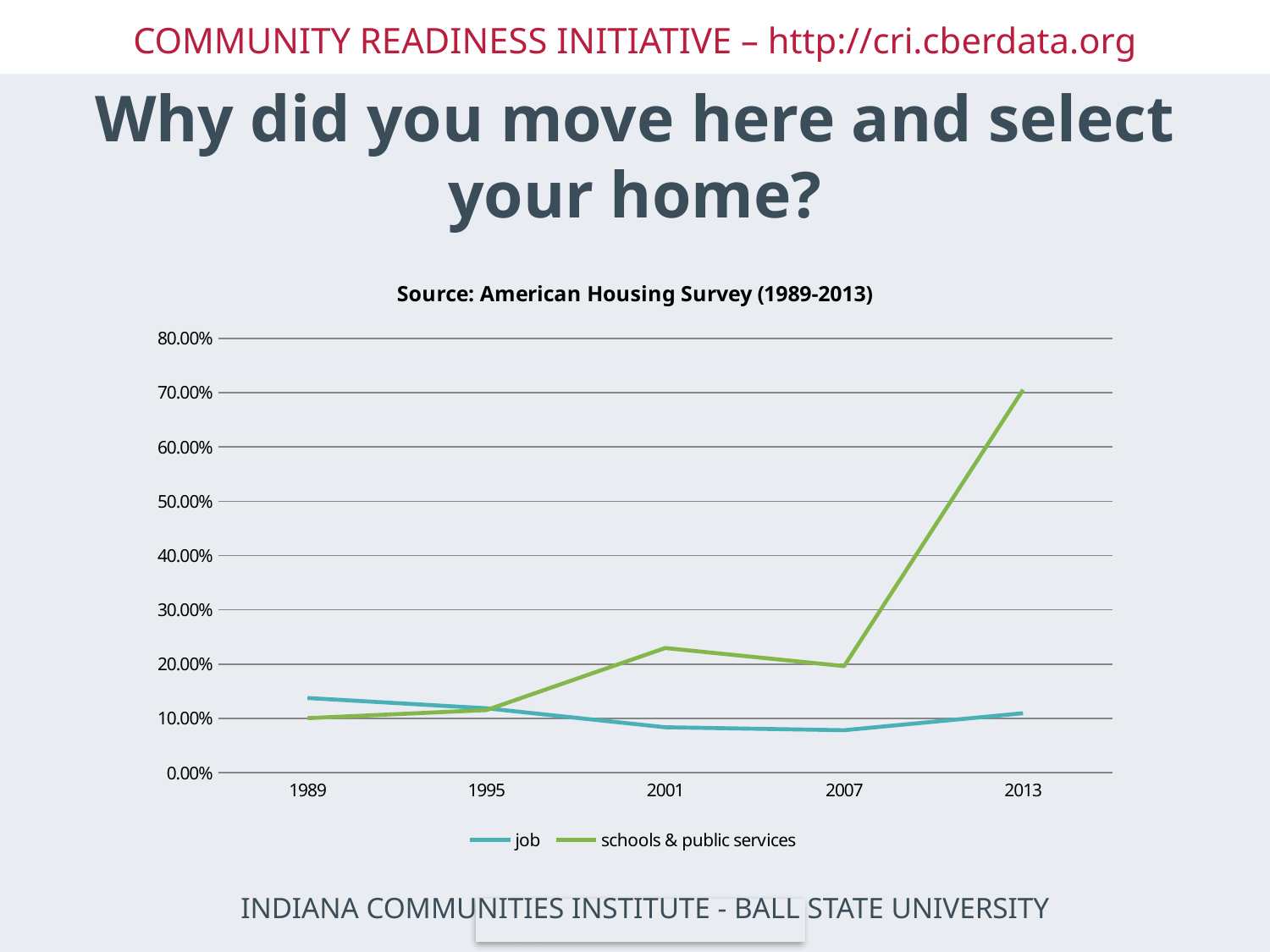
In which year does the 'schools & public services' series reach its highest value? 2013 Does the 'job' series rise or fall between 1989 and 2007? fall What kind of chart is shown on the slide? line chart In which year does the 'job' series reach its highest value? 1989 How many years are plotted along the x axis of the chart? 5 Is the value for 'schools & public services' in 2013 greater or less than 60.00%? greater Is the value for 'schools & public services' in 2001 greater or less than 20.00%? greater Is the value for 'job' in 2007 greater or less than 10.00%? less In 1989, which series has the larger value, 'job' or 'schools & public services'? job How many series does the chart's legend list? 2 What is the title of the chart? Source: American Housing Survey (1989-2013) In 2013, which series has the larger value, 'job' or 'schools & public services'? schools & public services